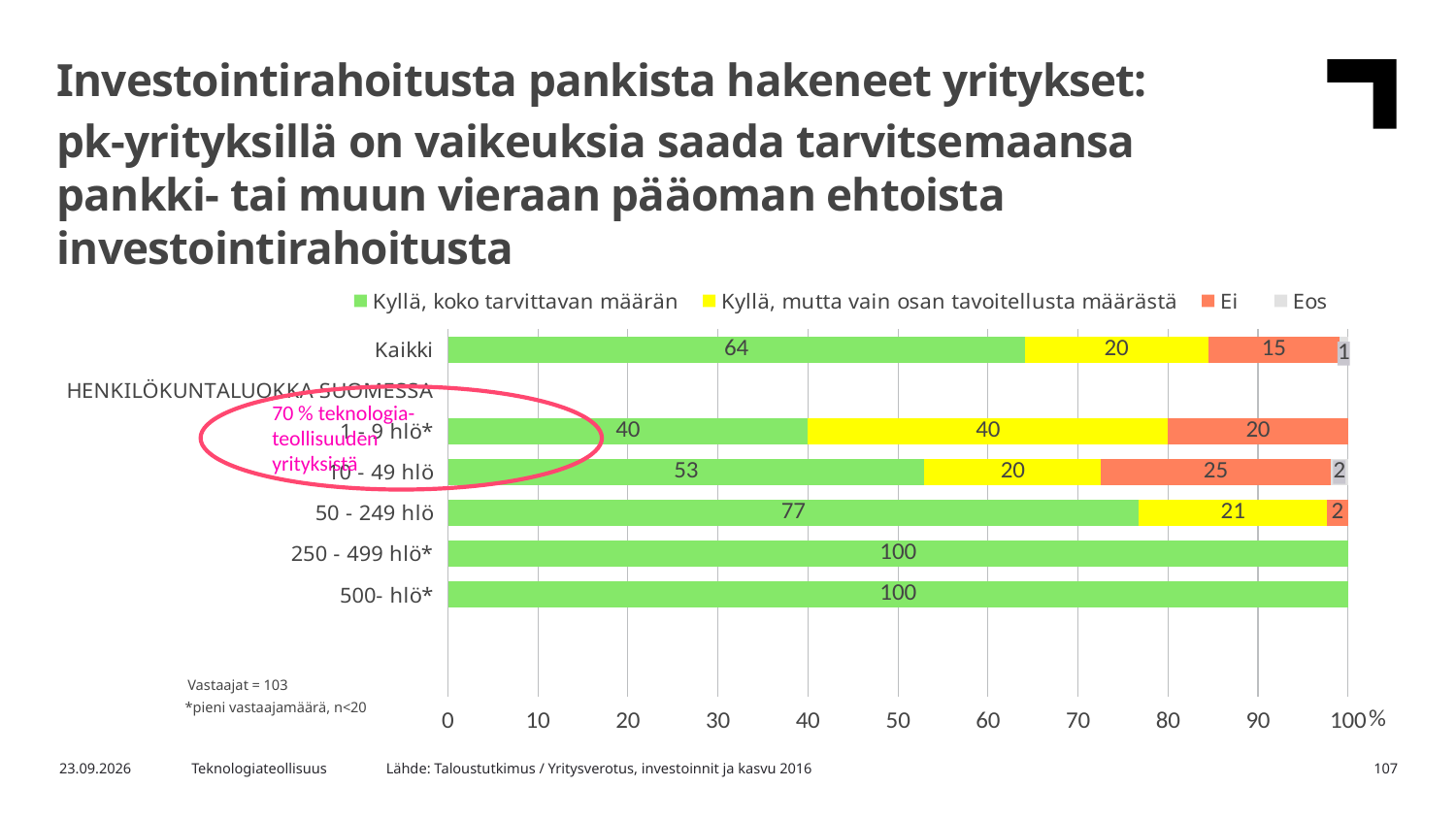
What is the difference between the "Kyllä, koko tarvittavan määrän" values for 50 - 249 hlö and 10 - 49 hlö? 24 How many categories are shown on the vertical axis of the chart? 6 What is the value of "Kyllä, koko tarvittavan määrän" for the 500- hlö* category? 100 What is the value of "Kyllä, mutta vain osan tavoitellusta määrästä" for the 1 - 9 hlö* category? 40 Which category has the lowest value for "Kyllä, koko tarvittavan määrän"? 1 - 9 hlö* What kind of chart is shown on the slide? Stacked bar chart Which is larger: the "Ei" value for 1 - 9 hlö* or for Kaikki? 1 - 9 hlö* What is the value of "Kyllä, koko tarvittavan määrän" for the Kaikki category? 64 How many series does the legend list? 4 Which colour represents the "Ei" series in the chart? Orange What is the value of "Ei" for the 10 - 49 hlö category? 25